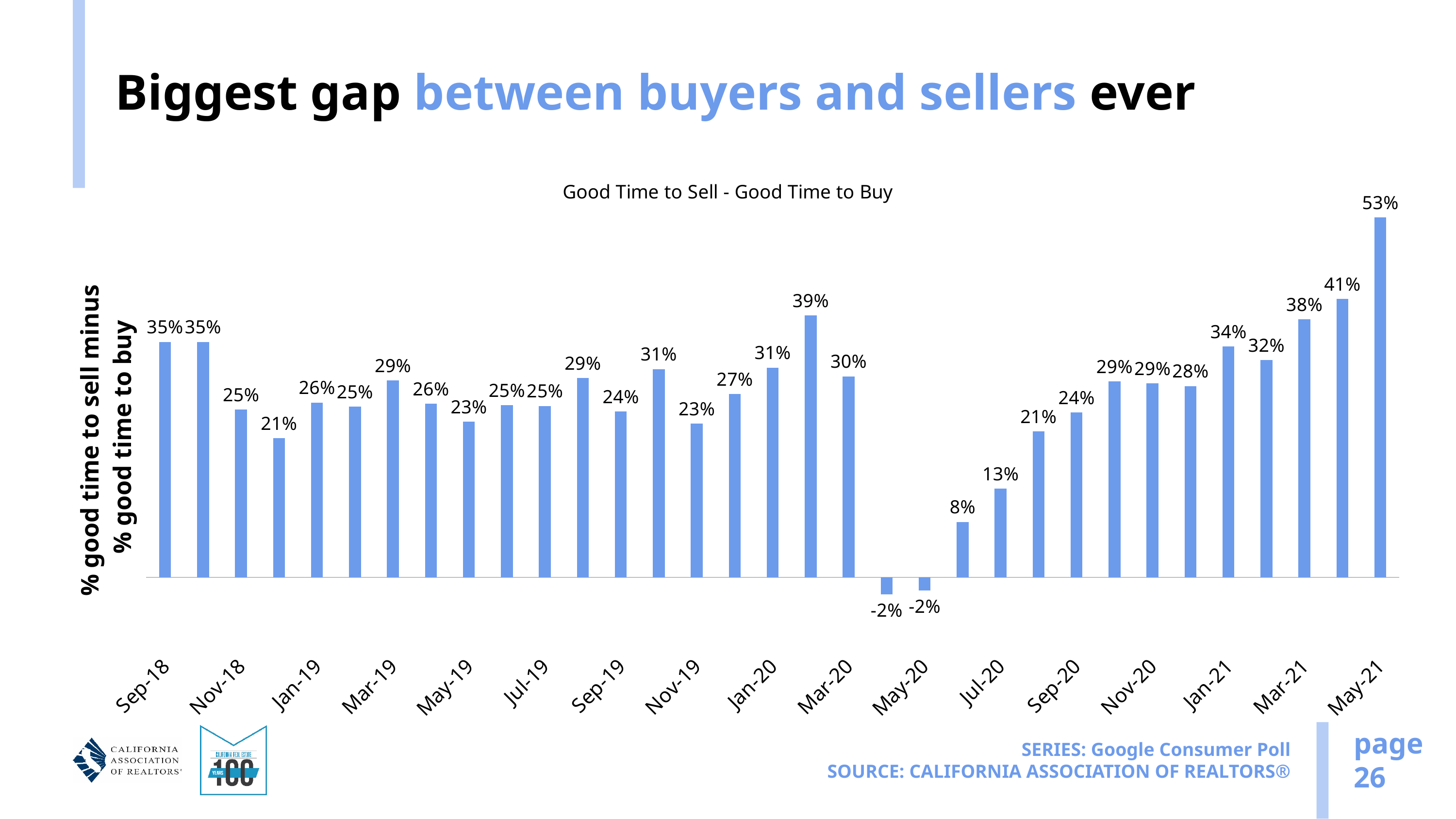
What is the difference between the values for Jan-21 and Sep-20? 10% What is the value for Jul-20? 13% Which month has the highest value? May-21 What is the value for Sep-18? 35% What is the title of the chart? Good Time to Sell - Good Time to Buy What is the difference between the values for May-21 and Mar-21? 15% What is the value for May-20? -2% What is the lowest value shown on the chart? -2% How many bars are plotted on the chart? 33 What is the value for May-21? 53% Which is larger, the value for Jan-20 or the value for Nov-19? Jan-20 What kind of chart is shown? Bar chart